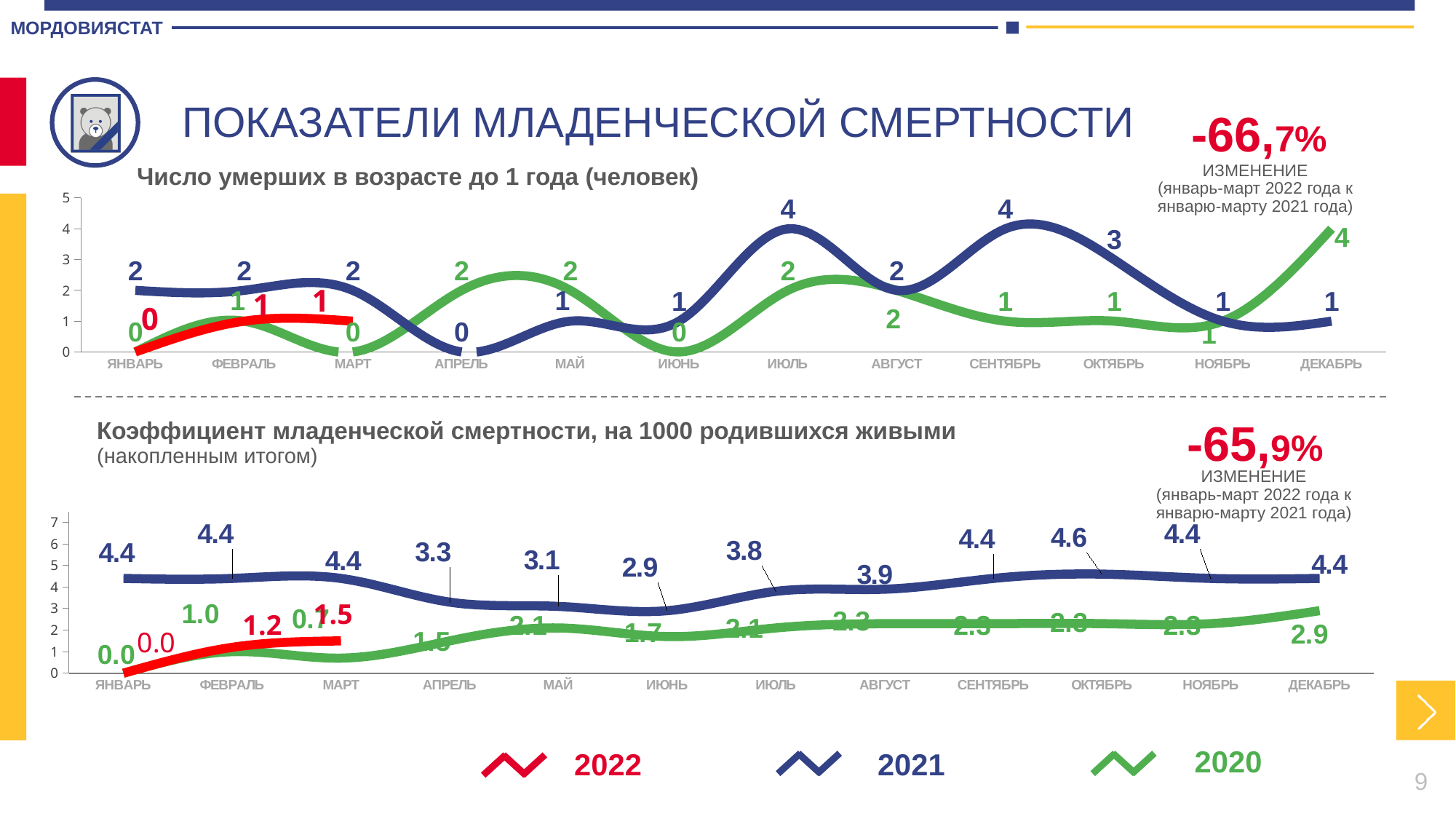
In the top chart (Число умерших в возрасте до 1 года), what is the difference between the 2021 value for СЕНТЯБРЬ and the 2021 value for ОКТЯБРЬ? 1 In the bottom chart (Коэффициент младенческой смертности), which month has the highest 2021 value? ОКТЯБРЬ In the bottom chart (Коэффициент младенческой смертности), what is the 2021 value for ОКТЯБРЬ? 4.6 How many series does the legend at the bottom of the slide list? 3 In the top chart (Число умерших в возрасте до 1 года), what is the 2021 value for ИЮЛЬ? 4 What type of chart is the top chart (Число умерших в возрасте до 1 года)? Line chart In the bottom chart (Коэффициент младенческой смертности), what is the 2022 value for МАРТ? 1.5 In the bottom chart (Коэффициент младенческой смертности), what is the difference between the 2021 value and the 2020 value for ДЕКАБРЬ? 1.5 In the top chart (Число умерших в возрасте до 1 года), what is the 2020 value for ДЕКАБРЬ? 4 In the bottom chart (Коэффициент младенческой смертности), which is larger for ДЕКАБРЬ: the 2021 value or the 2020 value? 2021 In the bottom chart (Коэффициент младенческой смертности), what is the 2021 value for ИЮНЬ? 2.9 In the top chart (Число умерших в возрасте до 1 года), what is the 2021 value for АПРЕЛЬ? 0